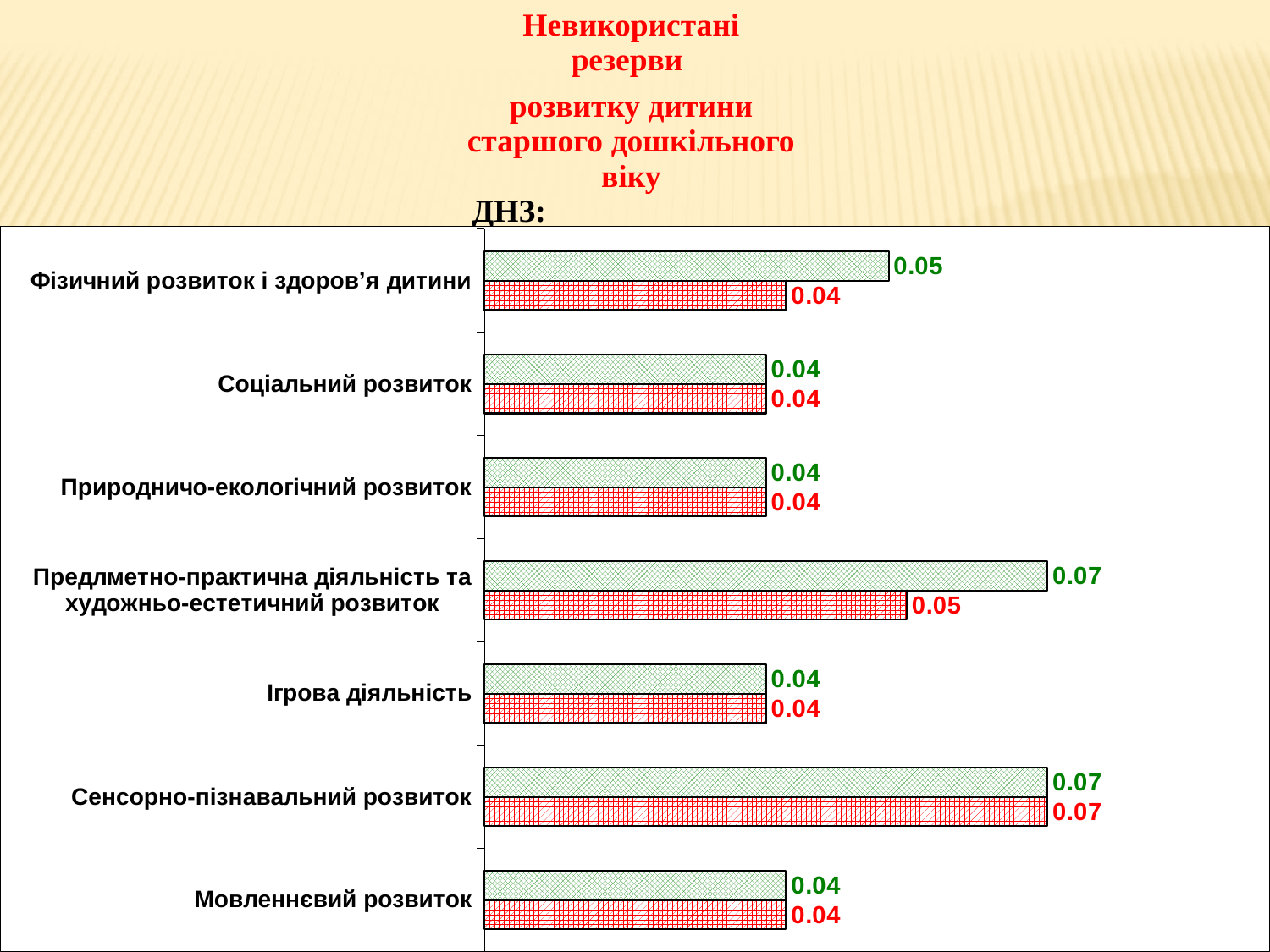
What is the value of the green-labelled (upper) bar for Фізичний розвиток і здоров’я дитини? 0.05 Which is larger for Предлметно-практична діяльність та художньо-естетичний розвиток: the green-labelled bar or the red-labelled bar? the green-labelled bar Which category has a larger green-labelled bar value: Сенсорно-пізнавальний розвиток or Ігрова діяльність? Сенсорно-пізнавальний розвиток Which category has the highest value for the red-labelled (lower) bar series? Сенсорно-пізнавальний розвиток How many categories are shown on the chart? 7 What is the value of the green-labelled (upper) bar for Сенсорно-пізнавальний розвиток? 0.07 What kind of chart is shown on the slide? bar chart What is the difference between the green-labelled and red-labelled bars for Фізичний розвиток і здоров’я дитини? 0.01 What is the value of the red-labelled (lower) bar for Предлметно-практична діяльність та художньо-естетичний розвиток? 0.05 What is the value of the green-labelled (upper) bar for Соціальний розвиток? 0.04 What is the value of the red-labelled (lower) bar for Мовленнєвий розвиток? 0.04 What is the difference between the green-labelled and red-labelled bars for Предлметно-практична діяльність та художньо-естетичний розвиток? 0.02